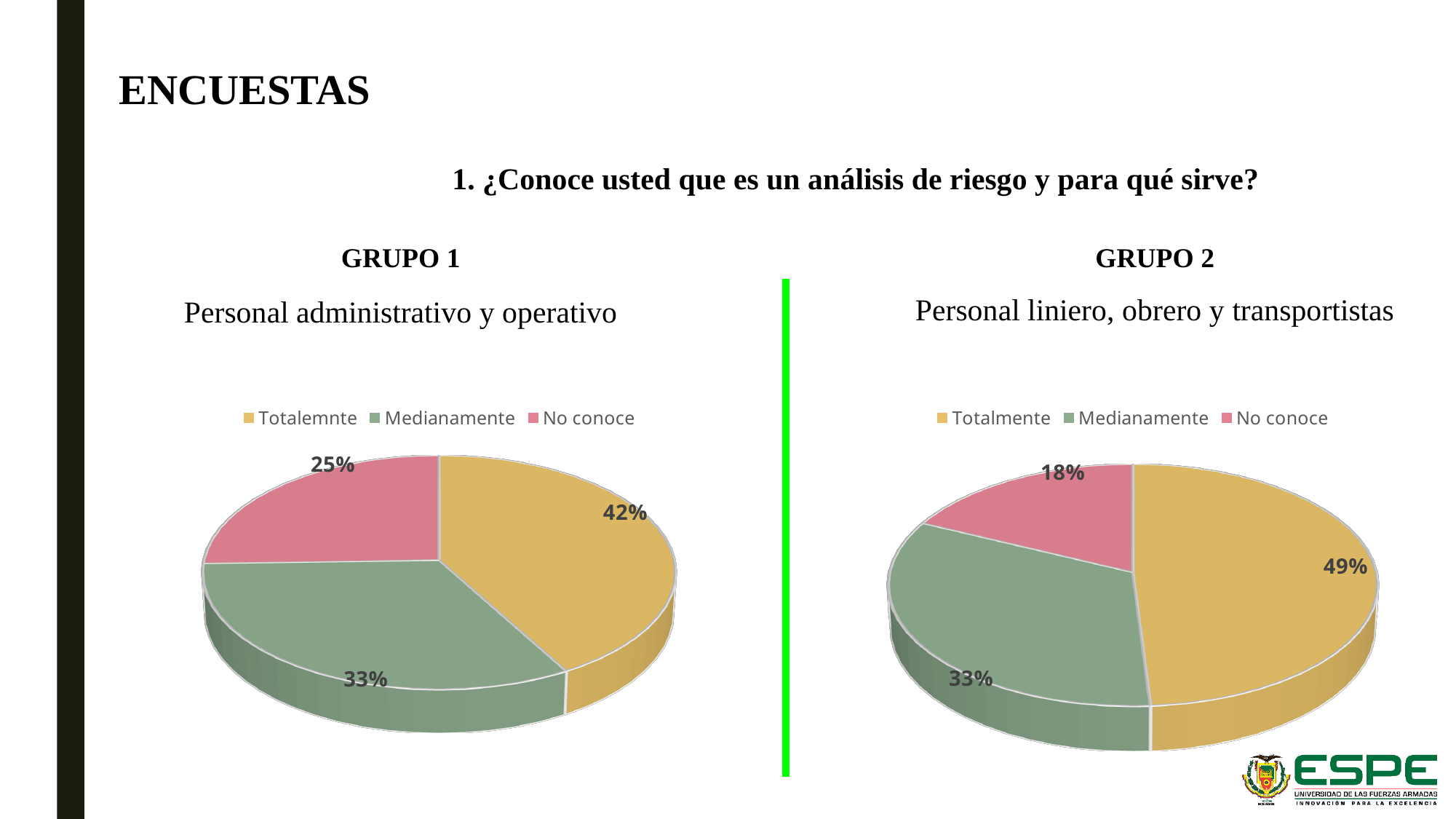
In the GRUPO 1 pie chart, what percentage is shown for No conoce? 25% How many slices does the GRUPO 2 pie chart have? 3 In the GRUPO 1 pie chart, what percentage is shown for Totalemnte? 42% Which colour represents No conoce in the GRUPO 2 chart legend? Pink/red In the GRUPO 2 pie chart, what percentage is shown for Totalmente? 49% In the GRUPO 1 pie chart, which category has the largest share? Totalemnte In the GRUPO 1 pie chart, what is the difference between the Totalemnte and Medianamente shares? 9% In the GRUPO 2 pie chart, what is the difference between the Totalmente and No conoce shares? 31% In the GRUPO 2 pie chart, what percentage is shown for Medianamente? 33% In the GRUPO 2 pie chart, which category has the smallest share? No conoce What type of chart is used for GRUPO 1? Pie chart Is the No conoce share larger in the GRUPO 1 chart or the GRUPO 2 chart? GRUPO 1